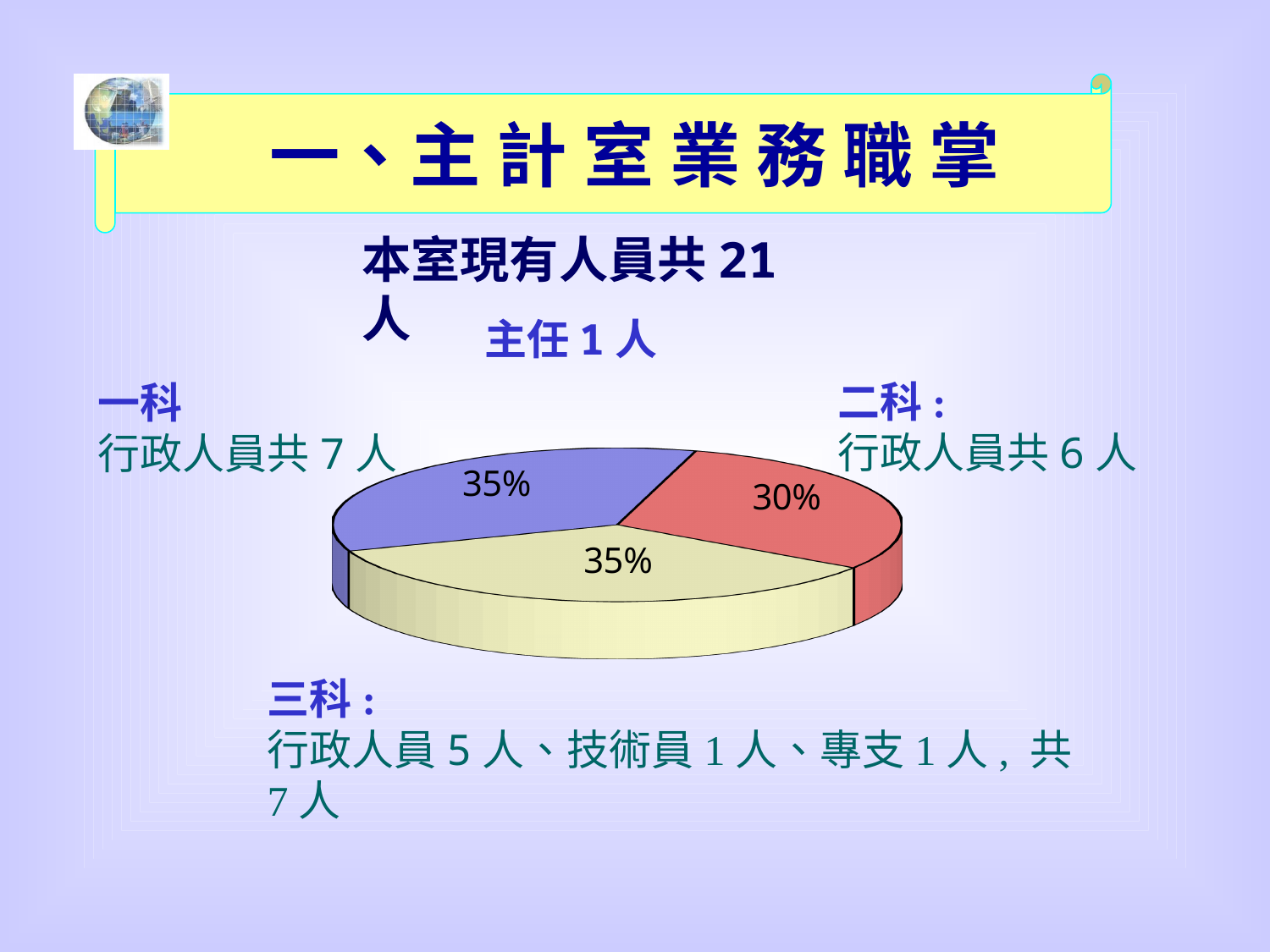
What percentage is shown on the blue slice of the pie chart? 35% What percentage is shown on the red slice of the pie chart? 30% What is the difference between the blue slice's percentage and the red slice's percentage? 5% What kind of chart is shown on the slide? pie chart Do the blue and yellow slices show the same percentage? yes What percentage is shown on the yellow slice of the pie chart? 35% What is the total number of staff stated above the pie chart (本室現有人員共)? 21 人 Which is larger, the yellow slice or the red slice? yellow slice Is the value of the red slice greater or less than 35%? less Which colour slice of the pie chart is the smallest? red How many slices does the pie chart have? 3 How many administrative staff does 二科 have according to the label next to the pie chart? 6 人